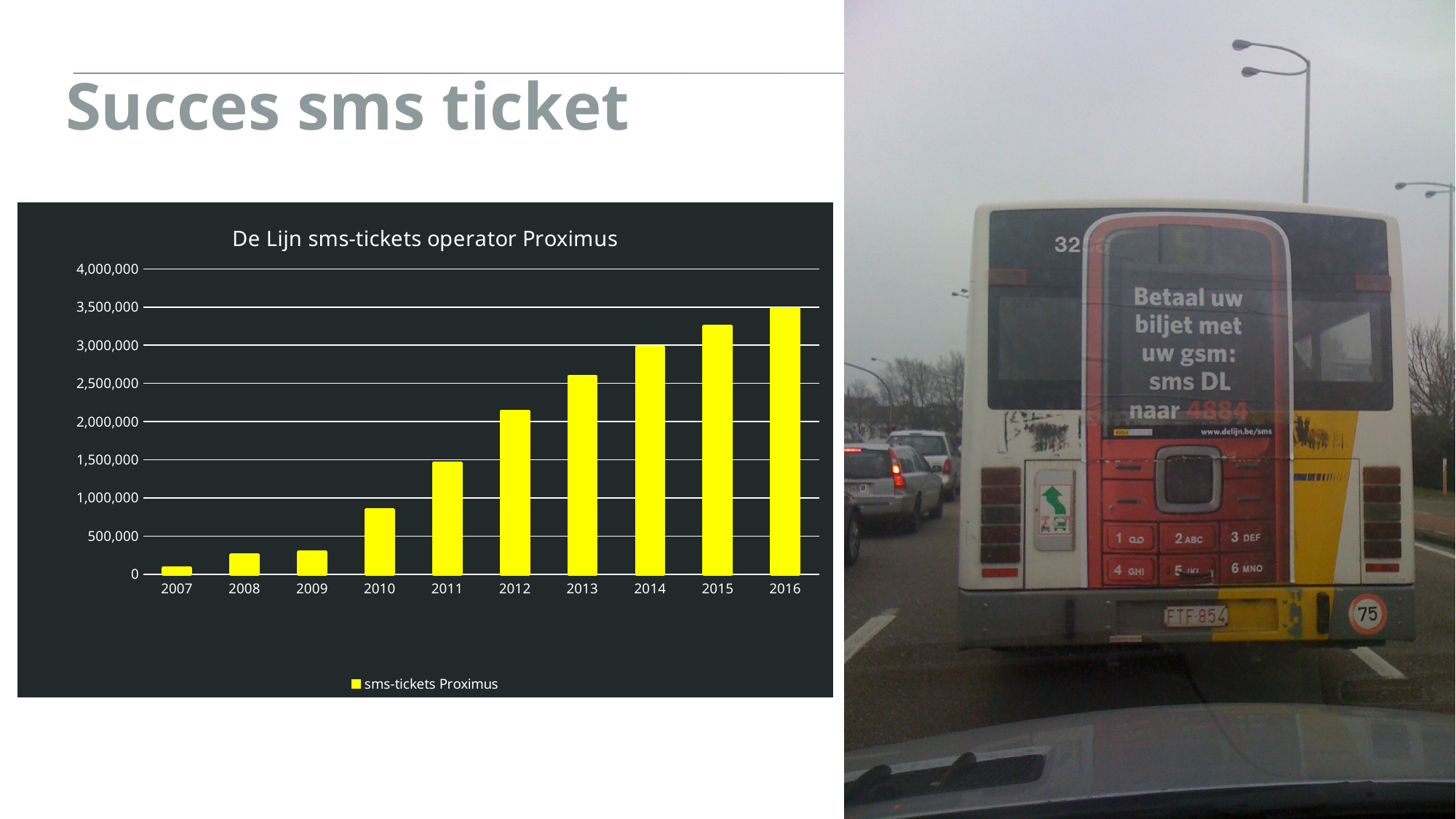
What is the title of the chart? De Lijn sms-tickets operator Proximus Is the value for 2009 greater or less than 500,000? less Is the value for 2013 greater or less than 3,000,000? less How many series does the chart legend list? 1 What is the name of the series in the chart legend? sms-tickets Proximus Which year has the highest number of sms-tickets? 2016 How many years are shown on the x axis of the chart? 10 Is the value for 2011 greater or less than 1,000,000? greater Do the values rise or fall from 2007 to 2016? rise Which year has more sms-tickets, 2010 or 2012? 2012 What kind of chart is shown on the slide? bar chart Which year has the lowest number of sms-tickets? 2007